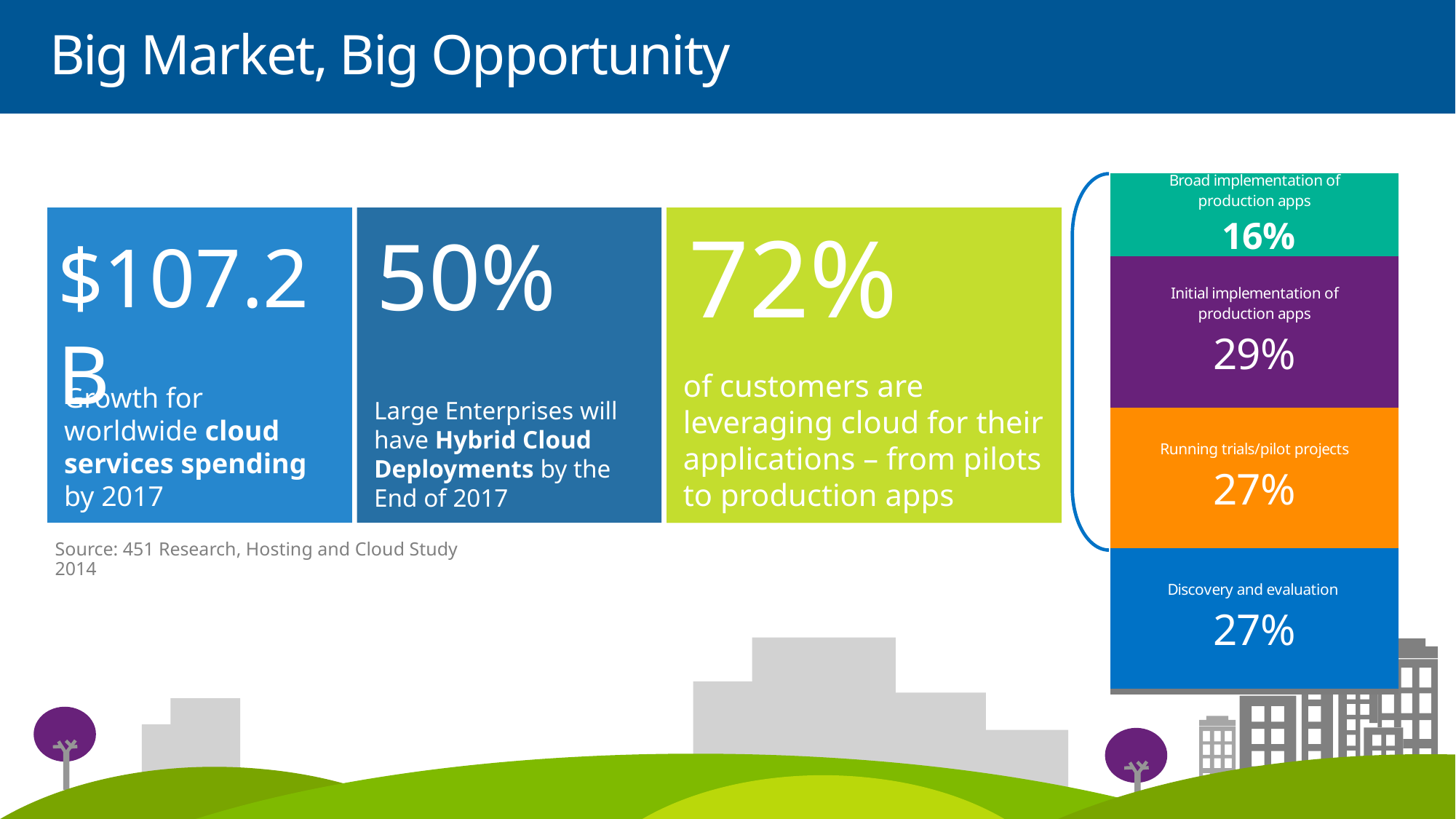
In the stacked bar on the right, which segment has the lowest percentage? Broad implementation of production apps In the stacked bar on the right, what percentage is shown for Discovery and evaluation? 27% How many segments does the stacked bar on the right have? 4 In the stacked bar on the right, which is larger: Running trials/pilot projects or Broad implementation of production apps? Running trials/pilot projects In the stacked bar on the right, what percentage is shown for Initial implementation of production apps? 29% In the stacked bar on the right, what percentage is shown for Broad implementation of production apps? 16% In the stacked bar on the right, what colour is the Discovery and evaluation segment? Blue What kind of chart is shown on the right side of the slide? Stacked bar chart In the stacked bar on the right, what percentage is shown for Running trials/pilot projects? 27% In the stacked bar on the right, what is the difference between Initial implementation of production apps and Broad implementation of production apps? 13% In the stacked bar on the right, which segment has the highest percentage? Initial implementation of production apps In the stacked bar on the right, what is the total of all four segment percentages? 99%